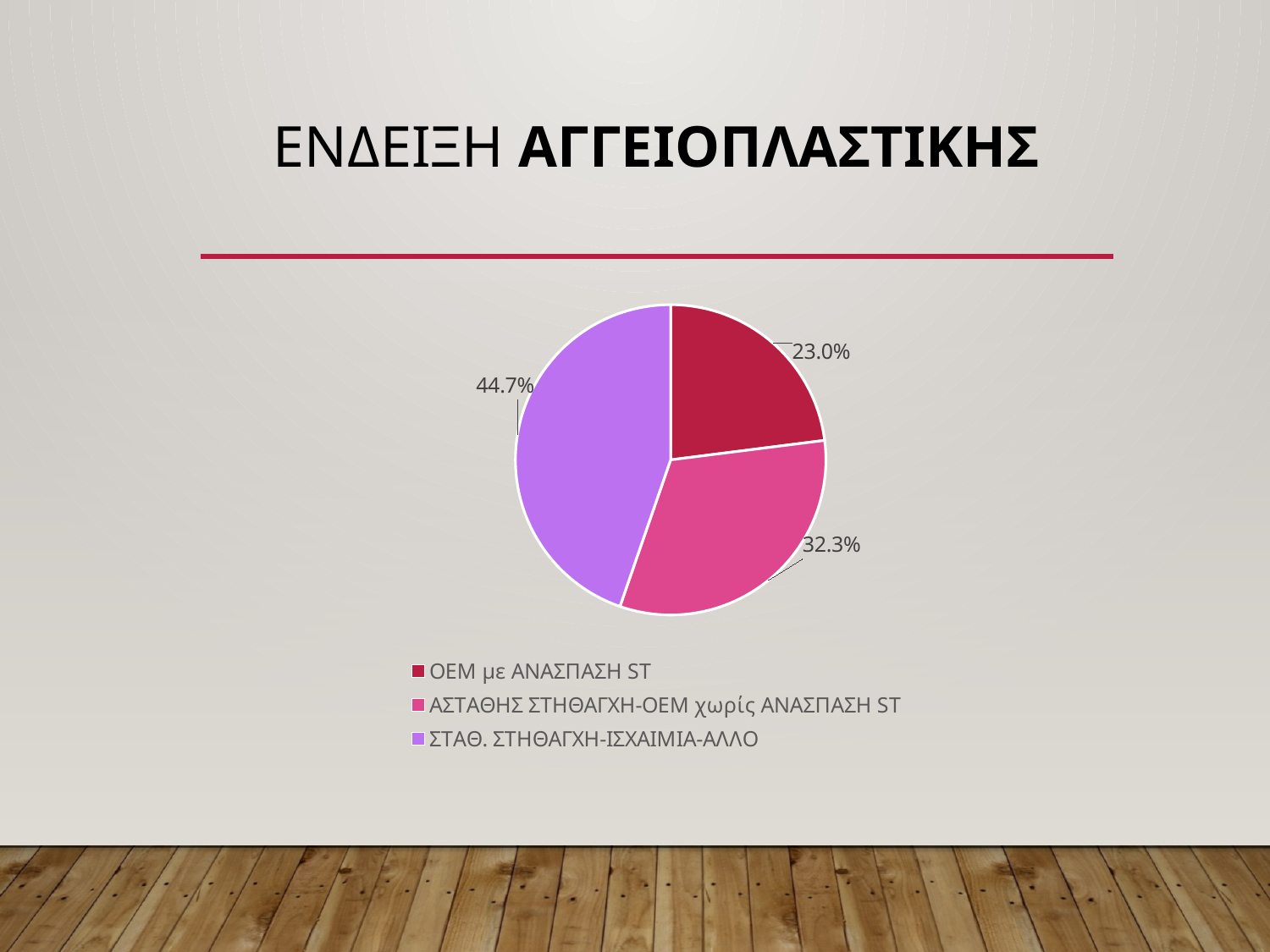
How many categories does the pie chart have? 3 What colour is the slice for ΣΤΑΘ. ΣΤΗΘΑΓΧΗ-ΙΣΧΑΙΜΙΑ-ΑΛΛΟ? purple What is the difference in percentage points between the ΑΣΤΑΘΗΣ ΣΤΗΘΑΓΧΗ-ΟΕΜ χωρίς ΑΝΑΣΠΑΣΗ ST slice and the ΟΕΜ με ΑΝΑΣΠΑΣΗ ST slice? 9.3% What share of the pie does ΣΤΑΘ. ΣΤΗΘΑΓΧΗ-ΙΣΧΑΙΜΙΑ-ΑΛΛΟ represent? 44.7% What kind of chart is shown on the slide? pie chart What is the title of the slide? ΕΝΔΕΙΞΗ ΑΓΓΕΙΟΠΛΑΣΤΙΚΗΣ What is the difference in percentage points between the ΣΤΑΘ. ΣΤΗΘΑΓΧΗ-ΙΣΧΑΙΜΙΑ-ΑΛΛΟ slice and the ΟΕΜ με ΑΝΑΣΠΑΣΗ ST slice? 21.7% Which category has the smallest slice of the pie? ΟΕΜ με ΑΝΑΣΠΑΣΗ ST Which is larger: the slice for ΑΣΤΑΘΗΣ ΣΤΗΘΑΓΧΗ-ΟΕΜ χωρίς ΑΝΑΣΠΑΣΗ ST or the slice for ΟΕΜ με ΑΝΑΣΠΑΣΗ ST? ΑΣΤΑΘΗΣ ΣΤΗΘΑΓΧΗ-ΟΕΜ χωρίς ΑΝΑΣΠΑΣΗ ST Which category has the largest slice of the pie? ΣΤΑΘ. ΣΤΗΘΑΓΧΗ-ΙΣΧΑΙΜΙΑ-ΑΛΛΟ What share of the pie does ΑΣΤΑΘΗΣ ΣΤΗΘΑΓΧΗ-ΟΕΜ χωρίς ΑΝΑΣΠΑΣΗ ST represent? 32.3% What share of the pie does ΟΕΜ με ΑΝΑΣΠΑΣΗ ST represent? 23.0%